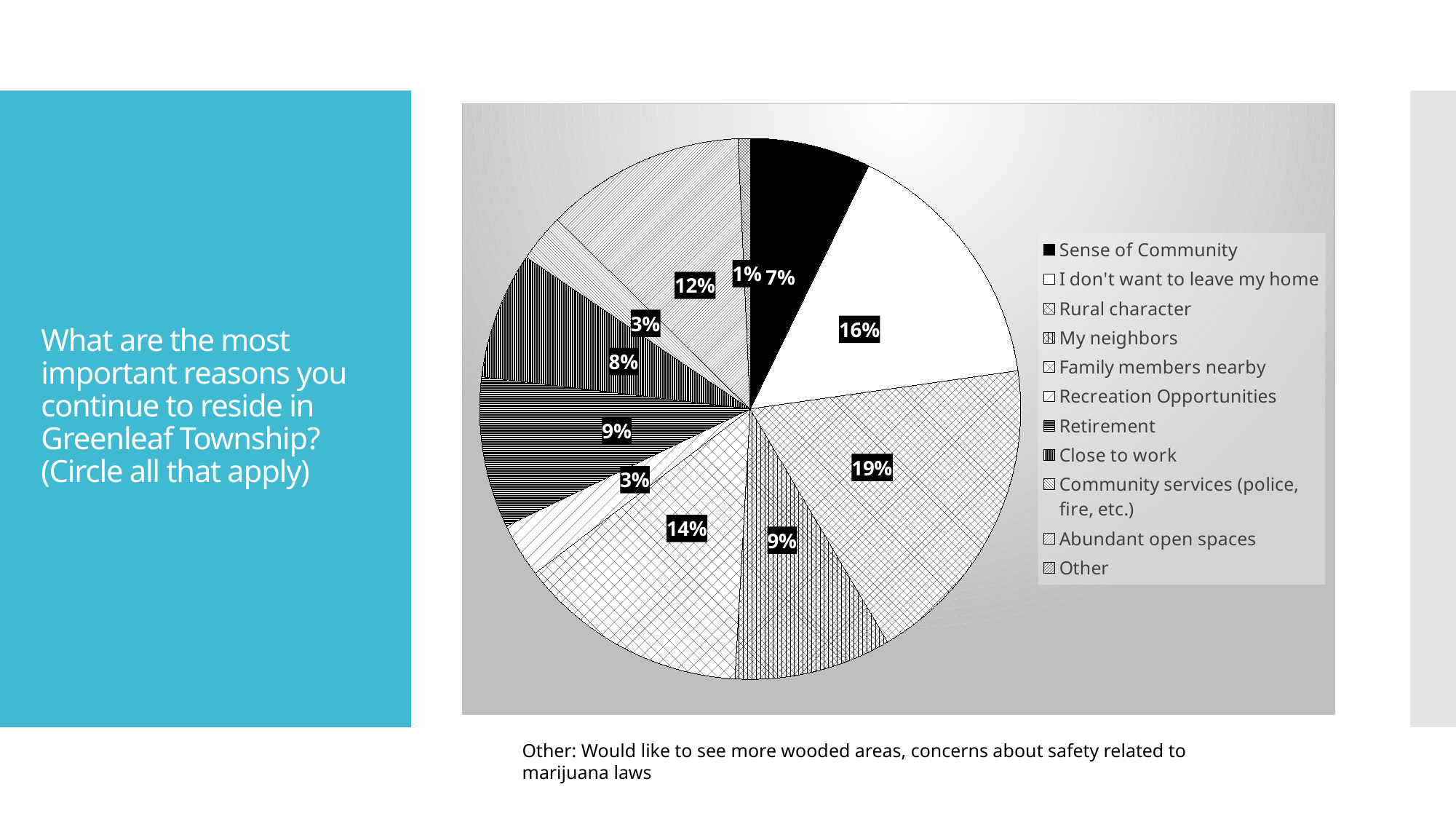
How many categories does the legend list? 11 Which has a larger share: Family members nearby or Abundant open spaces? Family members nearby What percentage of the pie is labelled for Rural character? 19% Which reason has the smallest share of the pie? Other What percentage is shown for Family members nearby? 14% What percentage is shown for I don't want to leave my home? 16% What is the difference in percentage points between Rural character and Sense of Community? 12 What percentage is shown for Abundant open spaces? 12% What percentage is shown for Close to work? 8% What type of chart is shown on the slide? pie chart What percentage is shown for Sense of Community? 7% Which reason has the largest share of the pie? Rural character